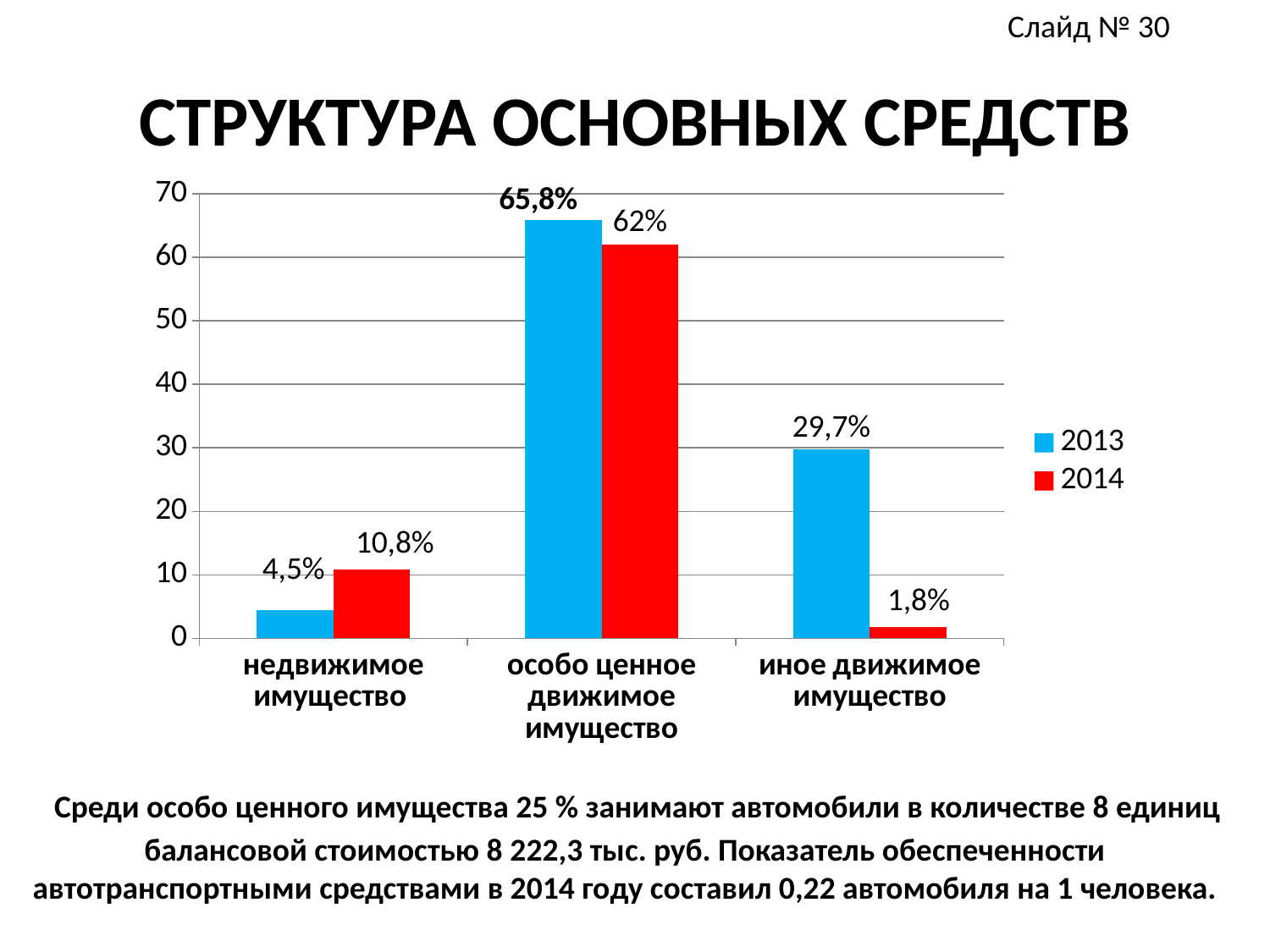
How many categories are shown on the x axis? 3 Which category has the highest 2013 value? особо ценное движимое имущество What is the difference between the 2014 and 2013 values for недвижимое имущество? 6,3% What is the 2014 value for особо ценное движимое имущество? 62% What is the 2013 value for недвижимое имущество? 4,5% What is the 2014 value for иное движимое имущество? 1,8% Which is larger for иное движимое имущество, the 2013 value or the 2014 value? 2013 How many series does the legend list? 2 Which category has the lowest 2014 value? иное движимое имущество Is the 2013 value for иное движимое имущество greater or less than 20? greater What is the title of the chart? СТРУКТУРА ОСНОВНЫХ СРЕДСТВ What kind of chart is shown on the slide? bar chart